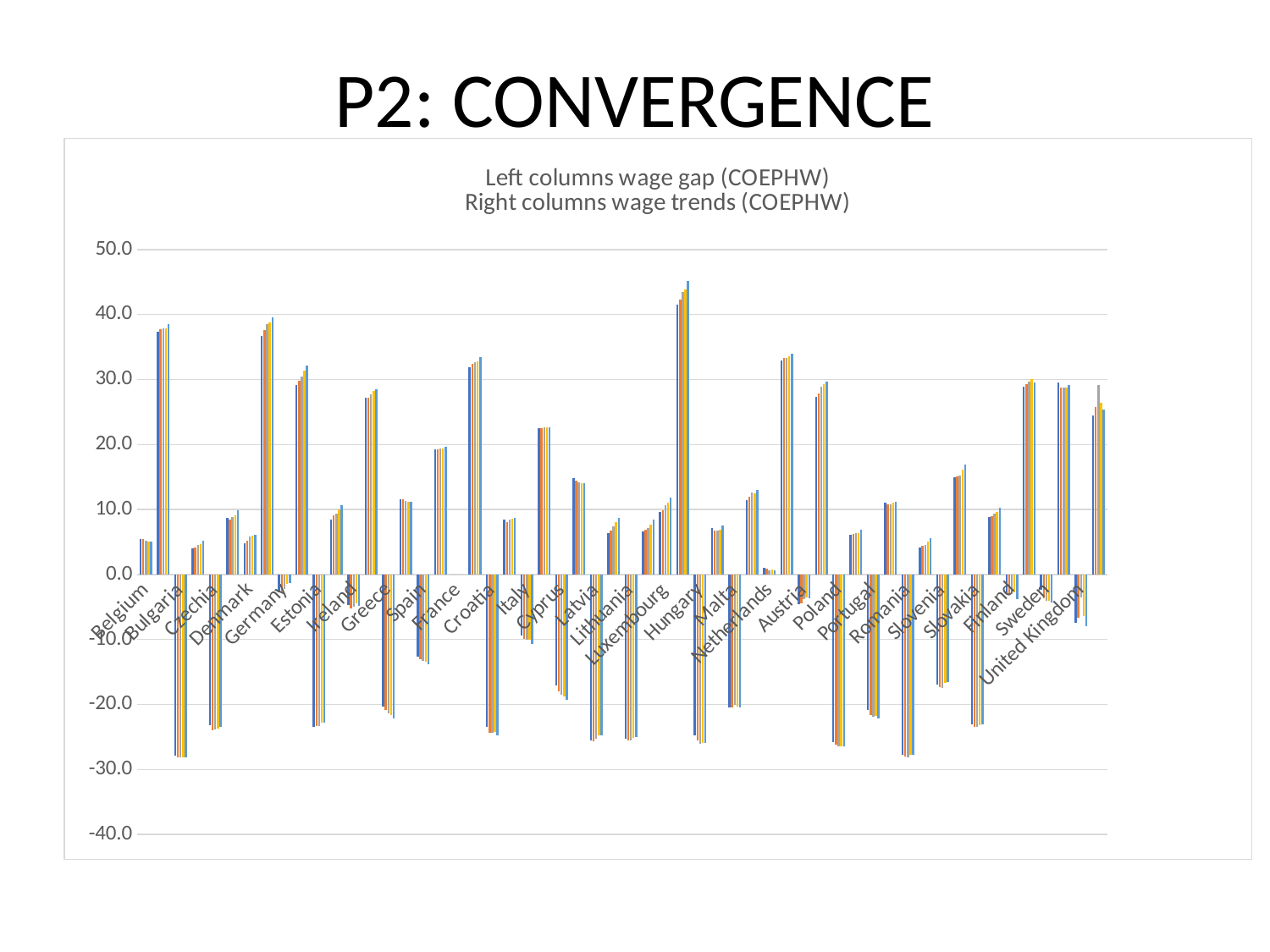
Which country has taller positive bars, Germany or Malta? Germany Which country has taller positive bars, Hungary or Belgium? Belgium How many countries are listed along the x axis of the chart? 28 Which country has the tallest positive bars in the chart? Luxembourg What is the title of the chart? Left columns wage gap (COEPHW) Right columns wage trends (COEPHW) What kind of chart is shown on the slide? bar chart What is the highest value shown on the vertical axis of the chart? 50.0 Are the positive bars for Hungary greater or less than 40.0? less Are the negative bars for Bulgaria greater or less than -20.0? less